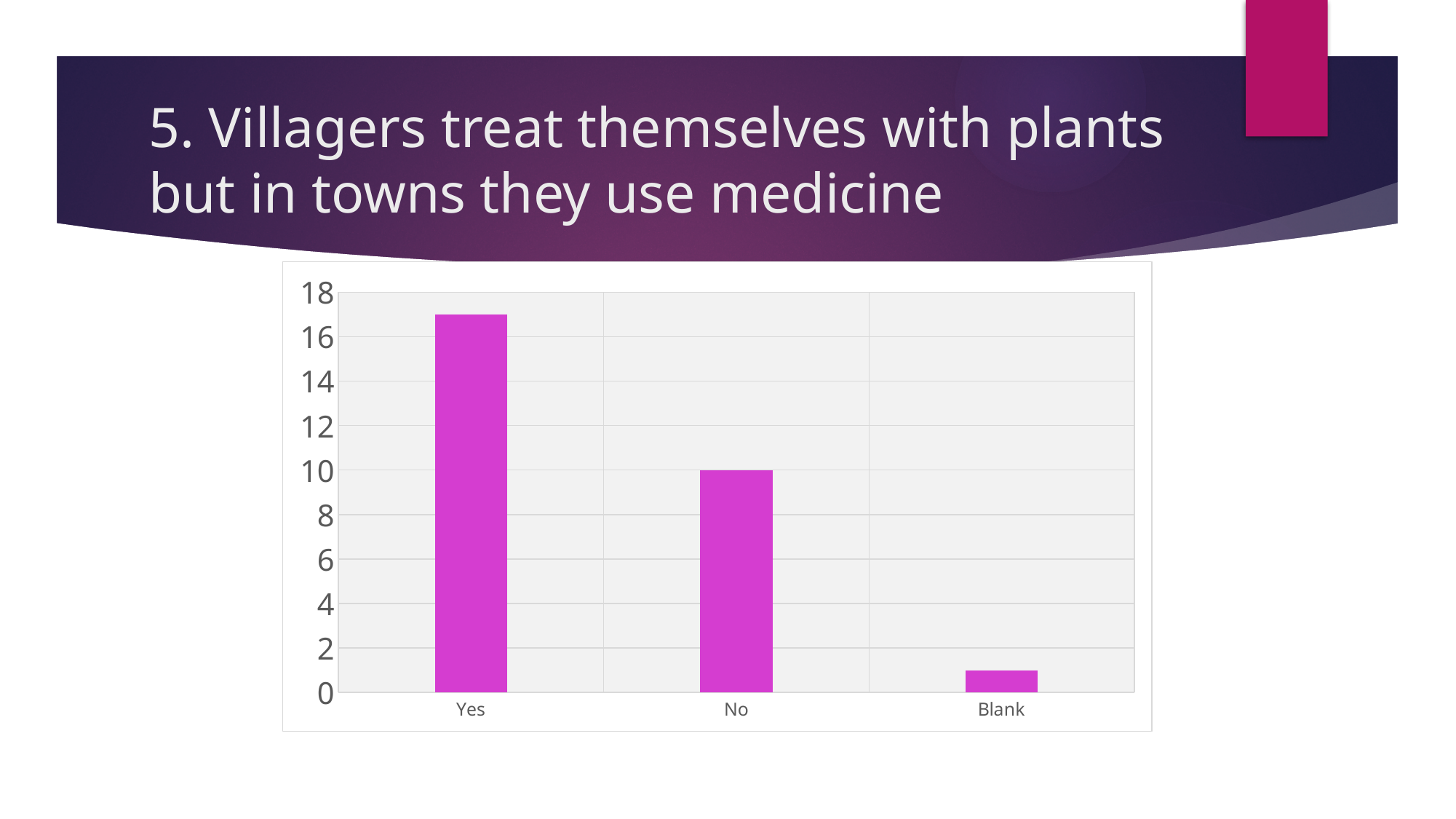
Which category has the highest bar in the chart? Yes Do the bar values rise or fall from left to right across the x axis? fall Which category has the lowest bar in the chart? Blank What is the value for No in the chart? 10 How many categories are shown on the x axis of the chart? 3 Is the value for No greater or less than 12? less What kind of chart is shown on the slide? bar chart Which is larger, the value for No or the value for Blank? No Which is larger, the value for Yes or the value for No? Yes What is the highest value shown on the y axis of the chart? 18 Is the value for Blank greater or less than 2? less Is the value for Yes greater or less than 16? greater